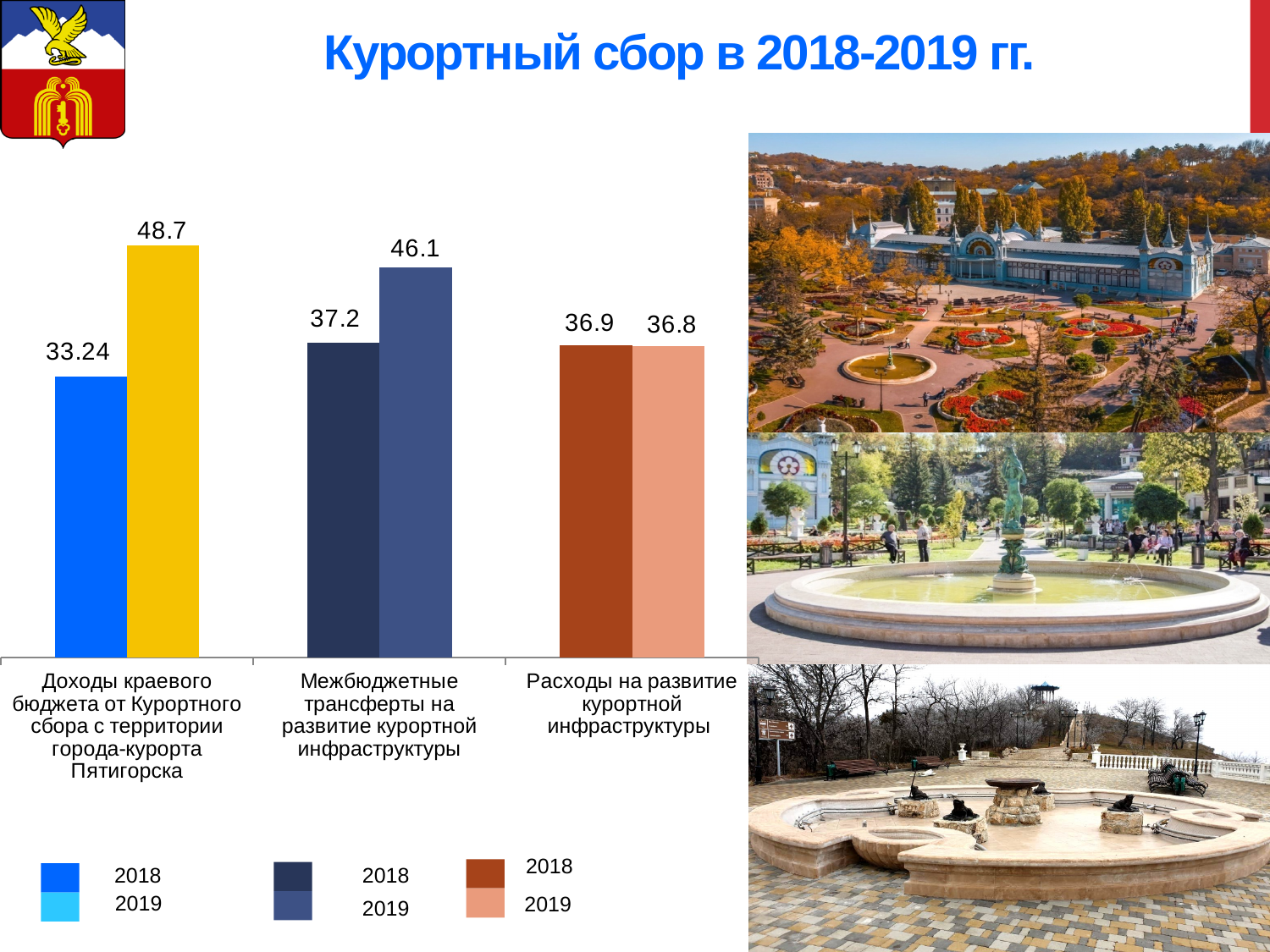
Which is larger: the 2019 value for 'Доходы краевого бюджета от Курортного сбора' or the 2019 value for 'Межбюджетные трансферты на развитие курортной инфраструктуры'? Доходы краевого бюджета от Курортного сбора (48.7) What is the 2019 value for 'Доходы краевого бюджета от Курортного сбора с территории города-курорта Пятигорска'? 48.7 What is the 2018 value for 'Расходы на развитие курортной инфраструктуры'? 36.9 What type of chart is shown on the slide? Bar chart What is the 2019 value for 'Расходы на развитие курортной инфраструктуры'? 36.8 Which bar has the lowest value on the chart? 2018 Доходы краевого бюджета от Курортного сбора (33.24) What is the 2019 value for 'Межбюджетные трансферты на развитие курортной инфраструктуры'? 46.1 What is the difference between the 2019 and 2018 values for 'Межбюджетные трансферты на развитие курортной инфраструктуры'? 8.9 How many categories are shown on the chart? 3 What is the 2018 value for 'Межбюджетные трансферты на развитие курортной инфраструктуры'? 37.2 What is the 2018 value for 'Доходы краевого бюджета от Курортного сбора с территории города-курорта Пятигорска'? 33.24 Which bar has the highest value on the chart? 2019 Доходы краевого бюджета от Курортного сбора (48.7)